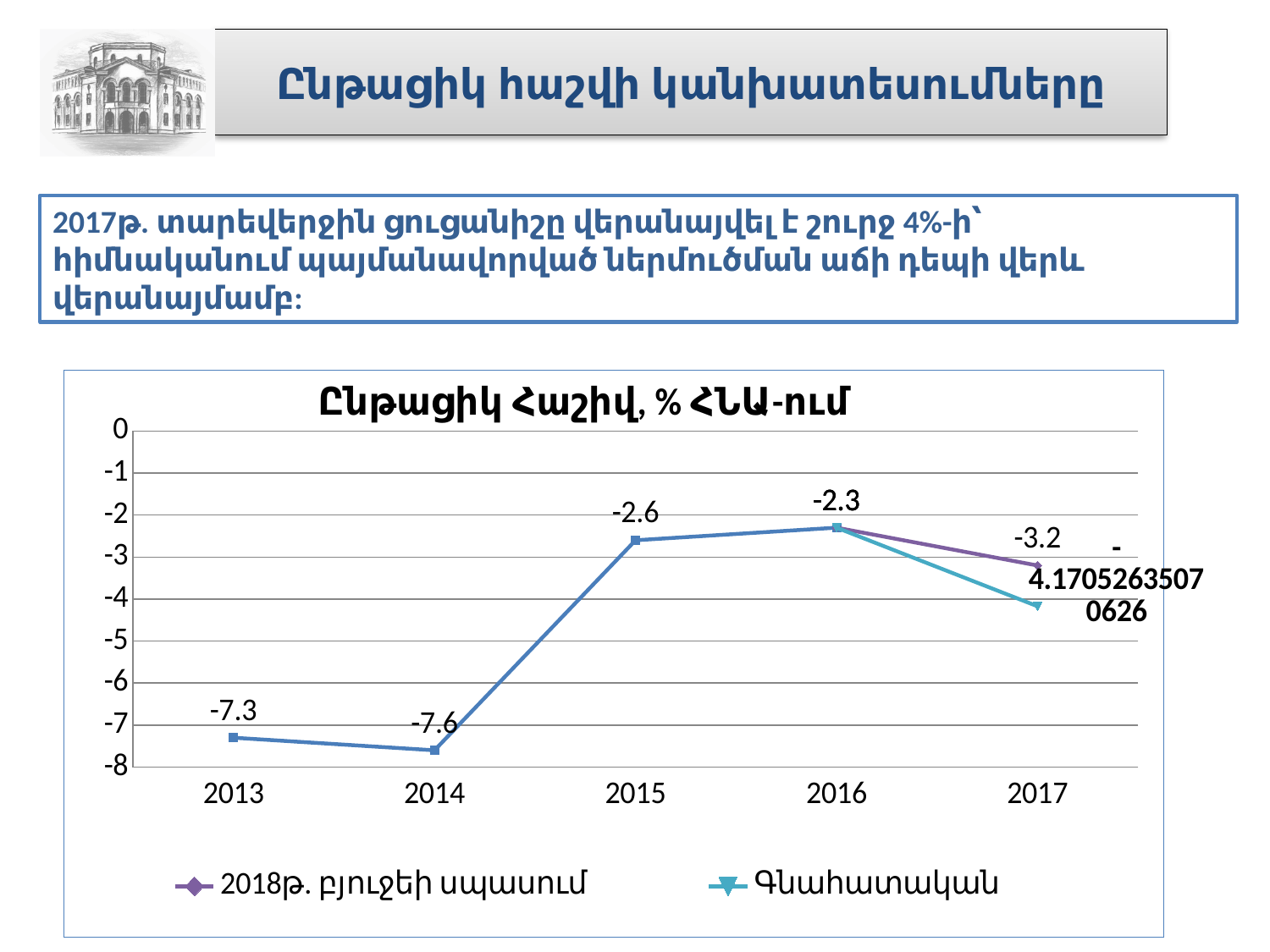
What is the value for 2017 in the '2018թ. բյուջեի սպասում' series? -3.2 Which is larger, the value for 2013 or the value for 2014? 2013 What is the difference between the values for 2015 and 2014? 5.0 How many years are shown on the x axis of the chart? 5 What is the value for 2015 in the chart? -2.6 Which year has the highest value in the chart? 2016 What is the value for 2013 in the chart? -7.3 How many series does the chart legend list? 2 What kind of chart is shown on the slide? line chart What is the value for 2016 in the chart? -2.3 What is the value for 2014 in the chart? -7.6 Which year has the lowest value in the chart? 2014